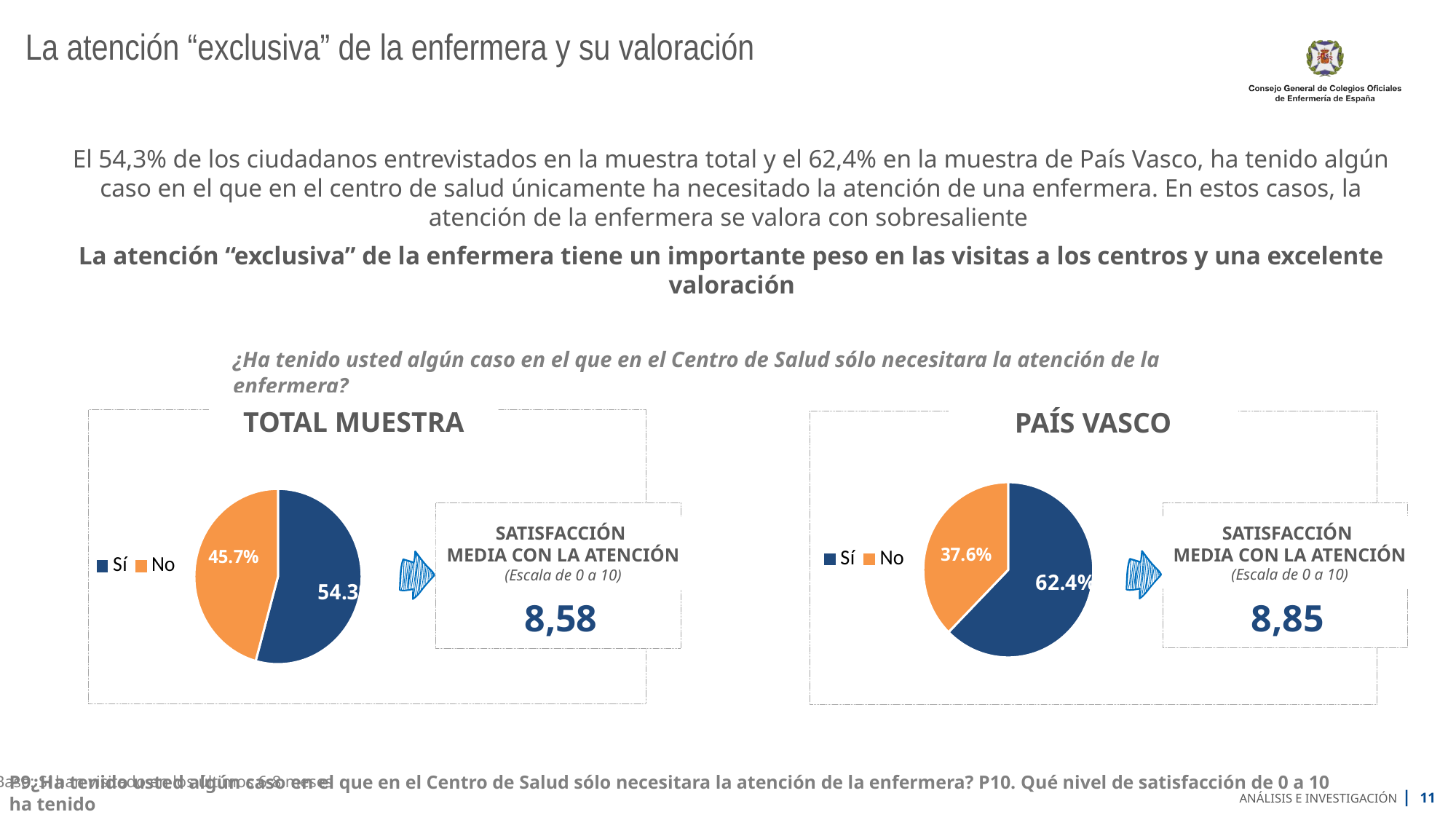
How many entries does the legend of the PAÍS VASCO pie chart list? 2 In the TOTAL MUESTRA pie chart, what percentage of respondents answered Sí? 54.3% What type of chart is used for TOTAL MUESTRA and PAÍS VASCO? Pie chart Is the Sí share larger in the TOTAL MUESTRA chart or in the PAÍS VASCO chart? PAÍS VASCO In the PAÍS VASCO pie chart, what colour is the Sí slice? Dark blue How many slices does the TOTAL MUESTRA pie chart have? 2 In the TOTAL MUESTRA pie chart, what percentage of respondents answered No? 45.7% In the TOTAL MUESTRA pie chart, which slice is the smallest? No In the PAÍS VASCO pie chart, which slice is the largest? Sí In the PAÍS VASCO pie chart, what percentage of respondents answered No? 37.6% In the PAÍS VASCO pie chart, what percentage of respondents answered Sí? 62.4% In the PAÍS VASCO pie chart, what is the difference in percentage points between the Sí and No slices? 24.8